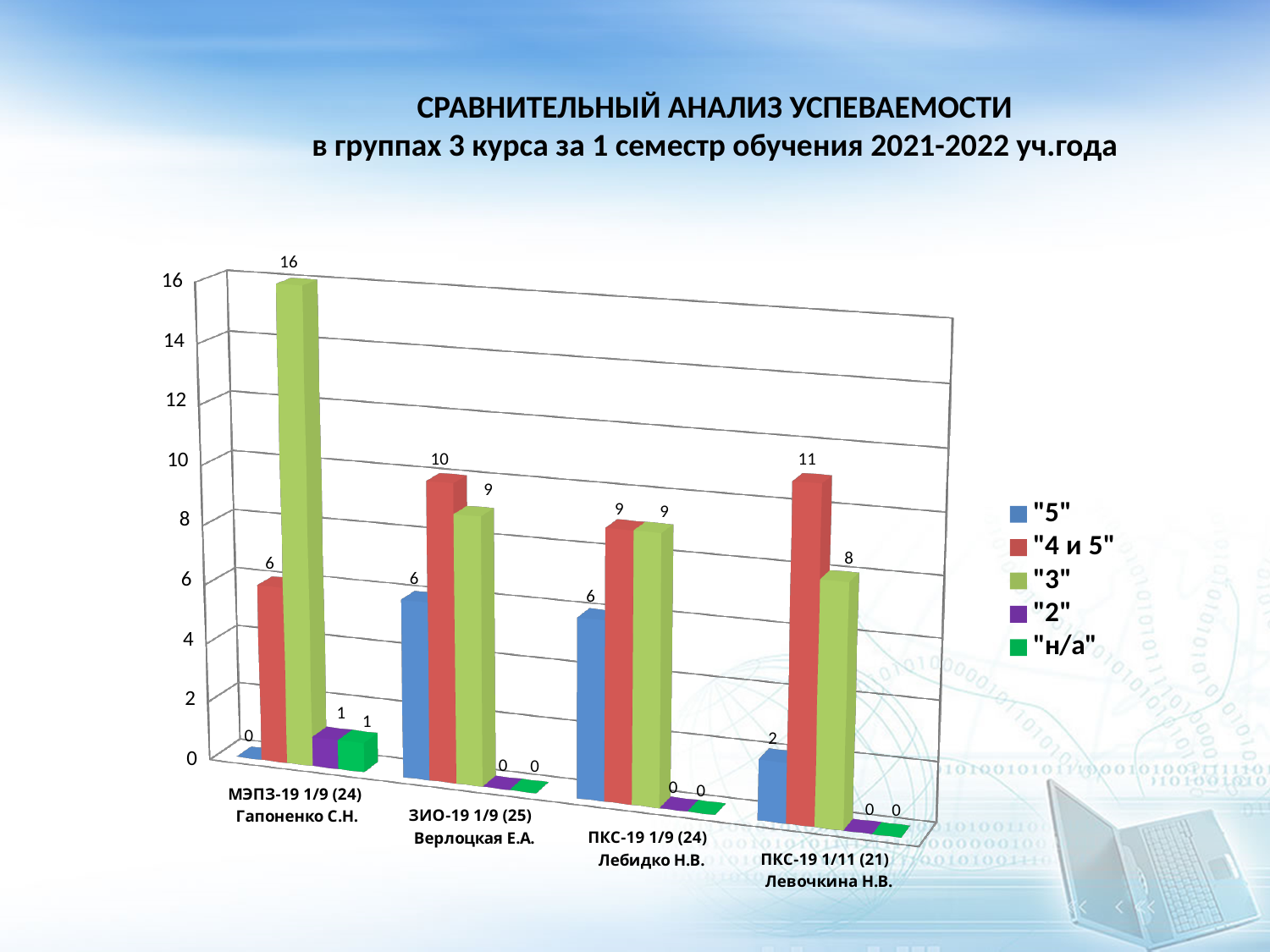
Which group has the highest value in the "3" series? МЭПЗ-19 1/9 (24) Гапоненко С.Н. What is the value of the "4 и 5" series for ПКС-19 1/11 (21) Левочкина Н.В.? 11 What is the difference between the "4 и 5" values for ПКС-19 1/11 (21) Левочкина Н.В. and ПКС-19 1/9 (24) Лебидко Н.В.? 2 Which is larger: the "4 и 5" value for ЗИО-19 1/9 (25) Верлоцкая Е.А. or the "3" value for ПКС-19 1/11 (21) Левочкина Н.В.? The "4 и 5" value for ЗИО-19 1/9 (25) Верлоцкая Е.А. How many series does the legend list? 5 What type of chart is shown on the slide? Bar chart Is the "3" value for МЭПЗ-19 1/9 (24) Гапоненко С.Н. greater or less than 14? greater What is the value of the "2" series for МЭПЗ-19 1/9 (24) Гапоненко С.Н.? 1 What is the value of the "3" series for МЭПЗ-19 1/9 (24) Гапоненко С.Н.? 16 Which group has the lowest value in the "5" series? МЭПЗ-19 1/9 (24) Гапоненко С.Н. What is the value of the "5" series for ЗИО-19 1/9 (25) Верлоцкая Е.А.? 6 How many groups (categories) are shown on the x axis? 4